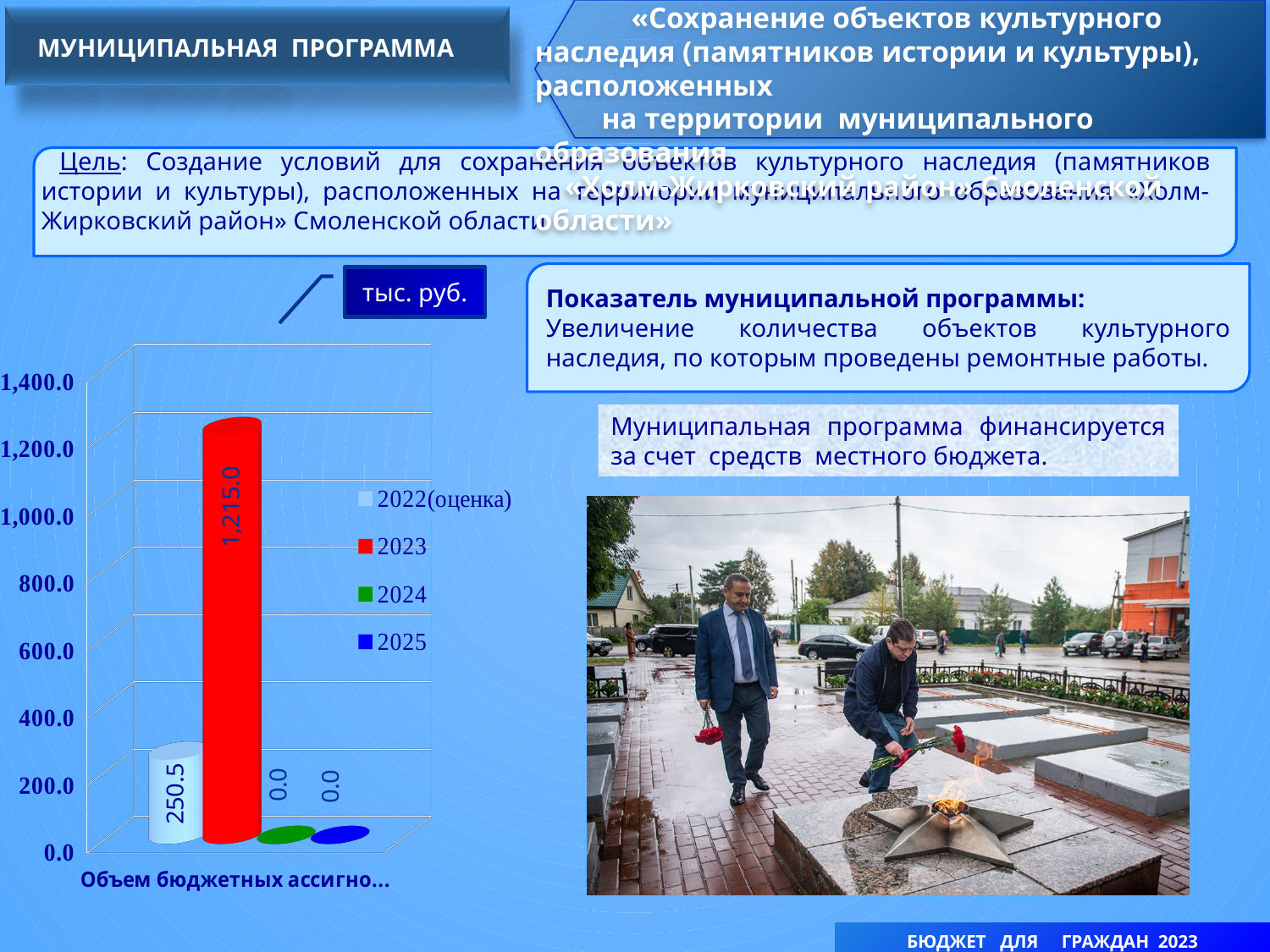
Which year has the highest value on the chart? 2023 What unit of measurement is indicated for the chart values? тыс. руб. Which is larger, the value for 2022(оценка) or the value for 2023? 2023 What is the value for 2023 on the chart? 1,215.0 How many series does the chart legend list? 4 Is the value for 2022(оценка) greater or less than 400.0? less What is the value for 2024 on the chart? 0.0 What is the value for 2022(оценка) on the chart? 250.5 Is the value for 2023 greater or less than 1,000.0? greater What kind of chart is shown on the slide? bar chart What is the value for 2025 on the chart? 0.0 What is the difference between the values for 2023 and 2022(оценка)? 964.5